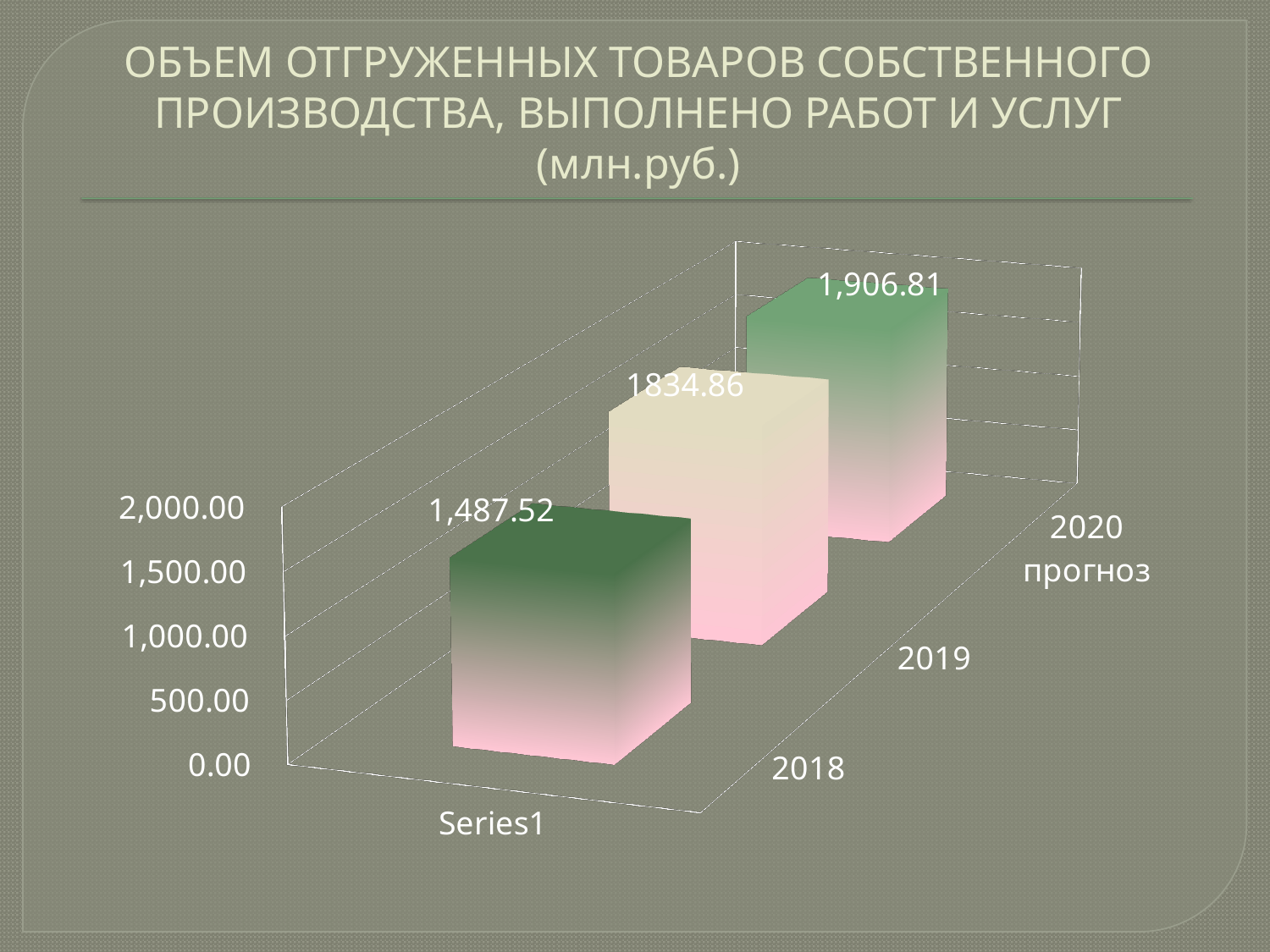
Which is larger, the value for 2019 or the value for 2018? 2019 What is the difference between the values for 2020 прогноз and 2018? 419.29 Is the value for 2018 greater or less than 1,500.00? less Do the values rise or fall from 2018 to 2020 прогноз? rise Which category has the highest value? 2020 прогноз What kind of chart is shown on the slide? bar chart What is the value for 2019? 1834.86 What is the value for 2018? 1,487.52 What is the difference between the values for 2019 and 2018? 347.34 Which category has the lowest value? 2018 What is the value for 2020 прогноз? 1,906.81 How many categories are shown on the chart? 3